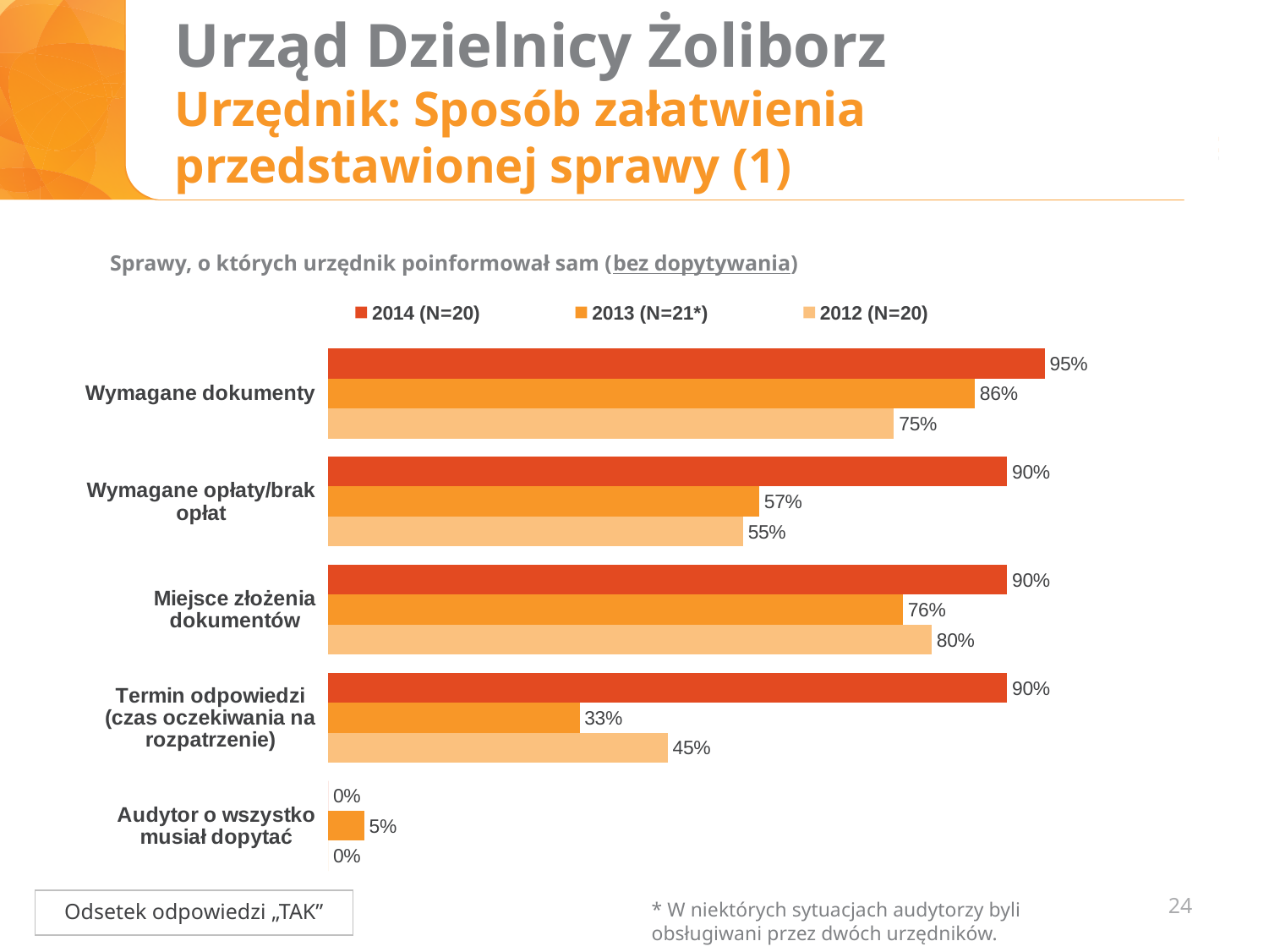
What is the value for "Audytor o wszystko musiał dopytać" in the 2013 (N=21*) series? 5% For "Miejsce złożenia dokumentów", which is larger: the 2013 (N=21*) value or the 2012 (N=20) value? 2012 (N=20) How many categories are shown on the chart? 5 Which category has the highest value in the 2014 (N=20) series? Wymagane dokumenty How many series does the legend list? 3 Which category has the lowest value in the 2012 (N=20) series? Audytor o wszystko musiał dopytać What is the value for "Miejsce złożenia dokumentów" in the 2012 (N=20) series? 80% What is the difference between the 2014 (N=20) and 2013 (N=21*) values for "Wymagane opłaty/brak opłat"? 33% What kind of chart is shown on the slide? Bar chart What is the value for "Termin odpowiedzi (czas oczekiwania na rozpatrzenie)" in the 2013 (N=21*) series? 33% What is the value for "Wymagane dokumenty" in the 2014 (N=20) series? 95% What is the subtitle text shown above the chart legend? Sprawy, o których urzędnik poinformował sam (bez dopytywania)